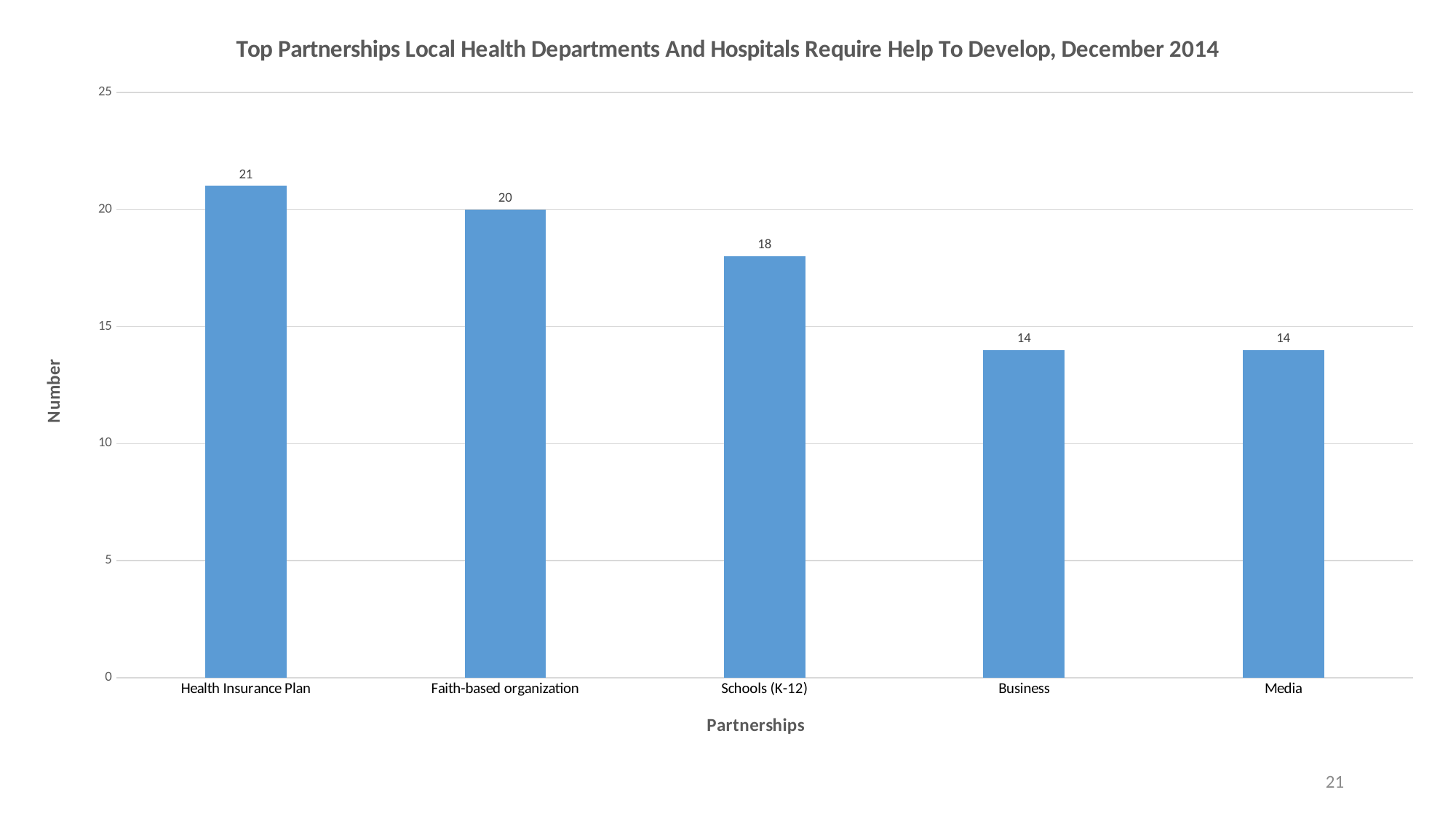
What is the label of the vertical axis? Number Is the value for Media greater or less than 15? less What is the difference between the values for Health Insurance Plan and Schools (K-12)? 3 What is the value for Schools (K-12)? 18 What is the difference between the values for Faith-based organization and Media? 6 What is the value for Faith-based organization? 20 Which is larger, the value for Faith-based organization or the value for Business? Faith-based organization What kind of chart is shown on the slide? bar chart Which partnership has the highest value? Health Insurance Plan What is the value for Business? 14 How many partnership categories are shown on the chart? 5 What is the value for Health Insurance Plan? 21